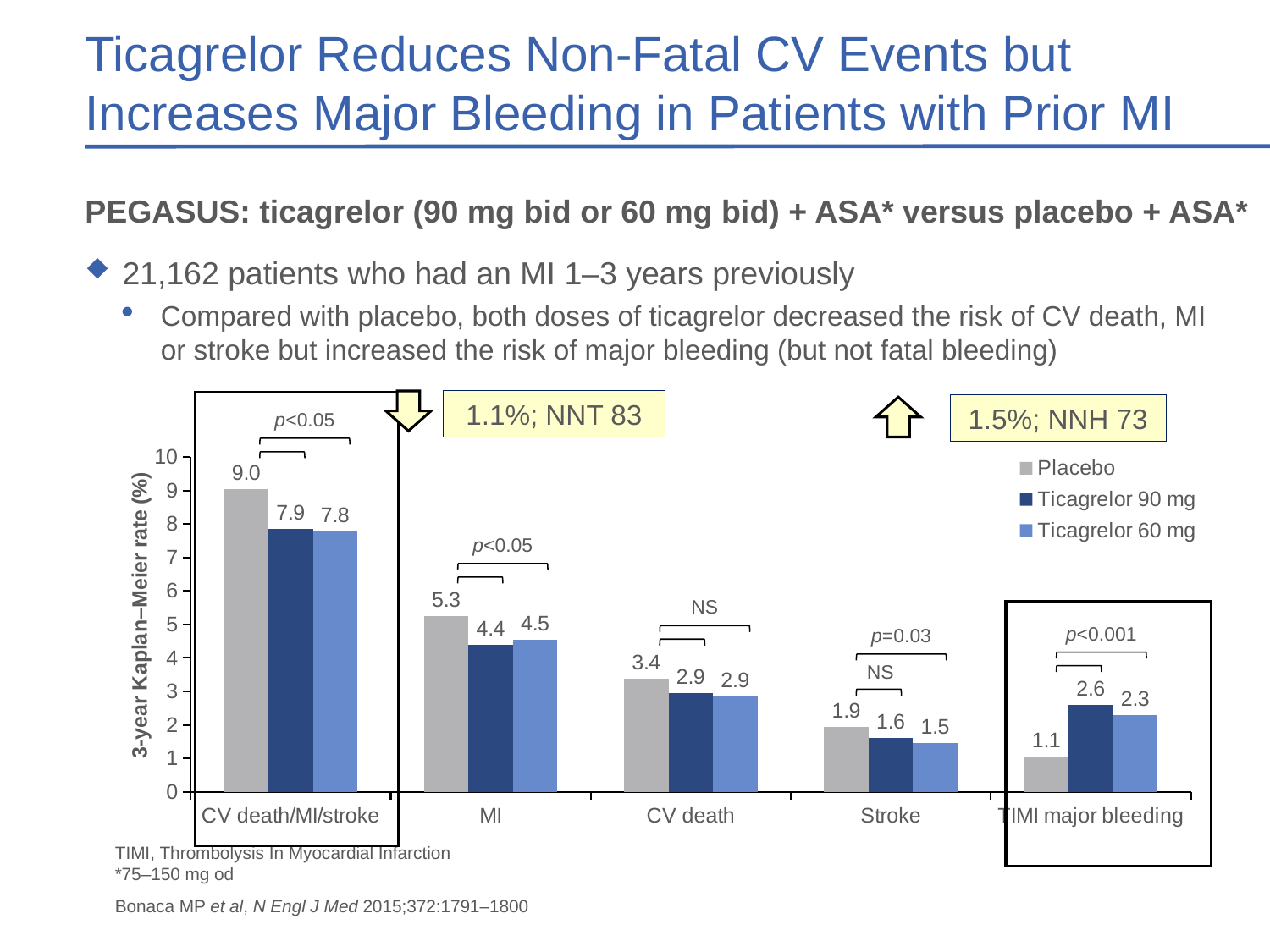
Which category has the lowest Placebo value? TIMI major bleeding What is the difference between the Placebo and Ticagrelor 90 mg values in the CV death/MI/stroke category? 1.1 What is the 3-year Kaplan–Meier rate for Placebo in the CV death/MI/stroke category? 9.0 How many categories are shown on the x axis? 5 Which category has the highest Placebo value? CV death/MI/stroke What kind of chart is shown on the slide? Bar chart What is the value for Ticagrelor 90 mg in the TIMI major bleeding category? 2.6 In the TIMI major bleeding category, which is larger: the Placebo value or the Ticagrelor 60 mg value? Ticagrelor 60 mg What is the label of the y axis? 3-year Kaplan–Meier rate (%) How many series does the legend list? 3 What is the value for Ticagrelor 60 mg in the MI category? 4.5 What is the value for Placebo in the Stroke category? 1.9